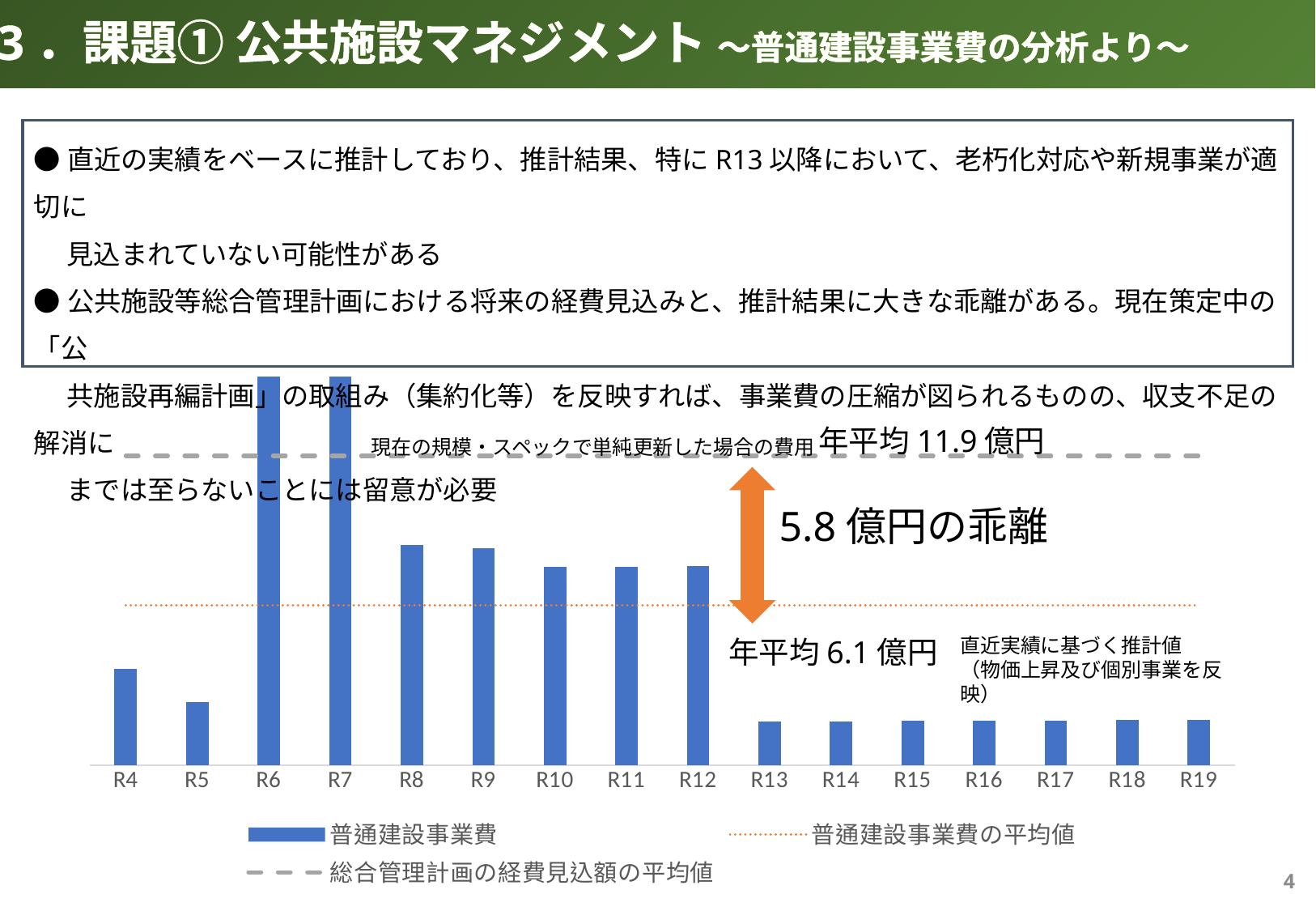
What kind of chart is shown on the slide? bar chart What colour are the bars for 普通建設事業費? blue Which bar is higher, R8 or R10? R8 How many series does the chart's legend list? 3 Do the bar values rise or fall from R8 to R12? fall Which bar is lower, R4 or R5? R5 What is the difference between the two annual averages (11.9 億円 and 6.1 億円) as labelled on the chart? 5.8 億円 How many categories (fiscal years) are shown on the x axis of the chart? 16 What annual average value is labelled for the dashed line (総合管理計画の経費見込額の平均値)? 年平均 11.9 億円 Which legend entry is represented by the dashed grey line? 総合管理計画の経費見込額の平均値 What annual average value is labelled for the dotted line (普通建設事業費の平均値)? 年平均 6.1 億円 Which bar is higher, R12 or R13? R12